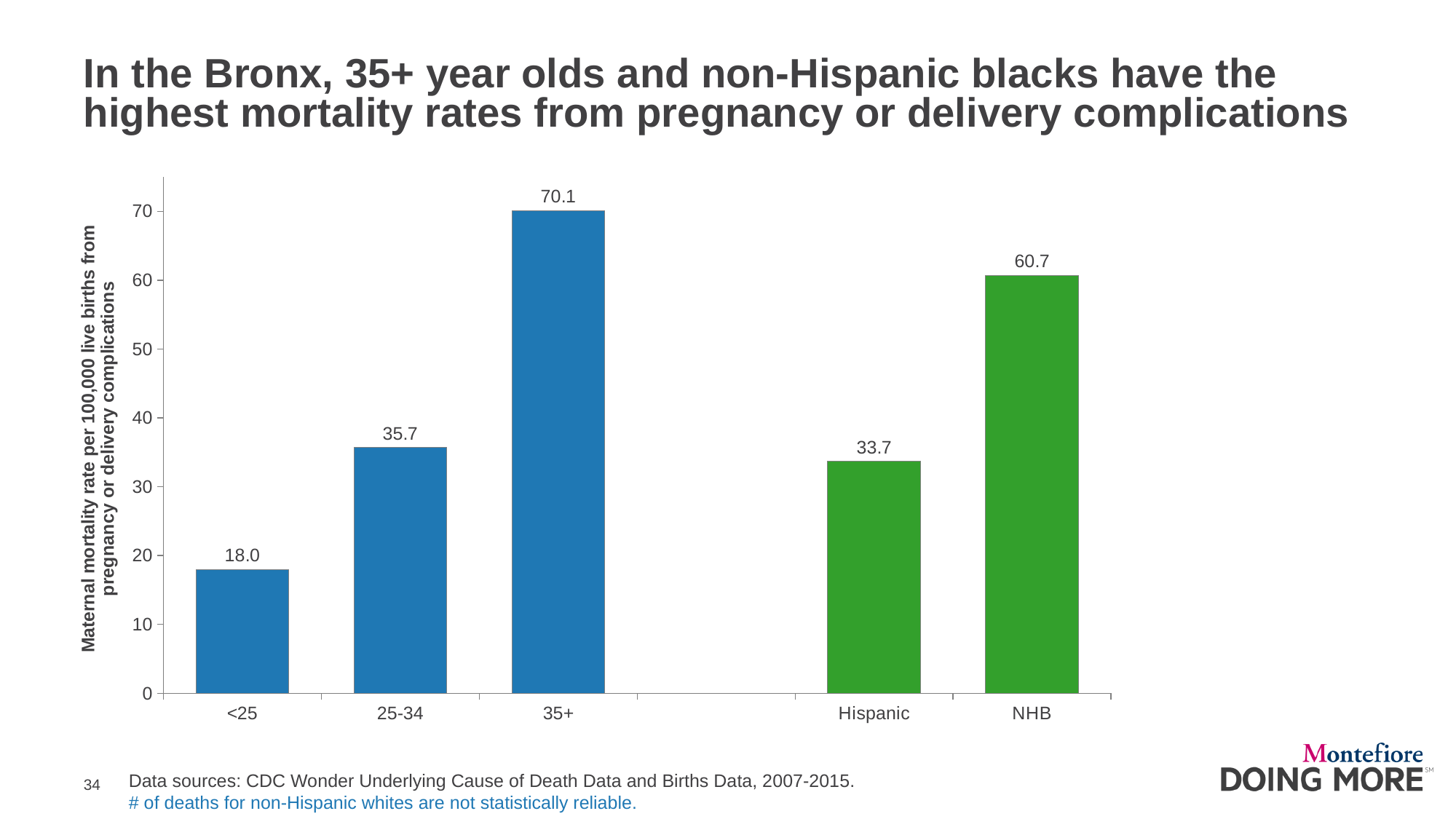
How many bars are plotted in the chart? 5 What is the maternal mortality rate for the <25 age group? 18.0 What is the difference between the maternal mortality rates for NHB and Hispanic women? 27.0 What type of chart is shown on the slide? bar chart What is the maternal mortality rate for the 35+ age group? 70.1 What is the difference between the maternal mortality rates for the 35+ and 25-34 age groups? 34.4 Which has a higher maternal mortality rate, the 25-34 age group or Hispanic women? 25-34 Which category has the highest maternal mortality rate? 35+ Which category has the lowest maternal mortality rate? <25 Is the maternal mortality rate for NHB greater or less than 50? greater What colour are the bars for the race/ethnicity categories (Hispanic and NHB)? green What is the maternal mortality rate for Hispanic women? 33.7